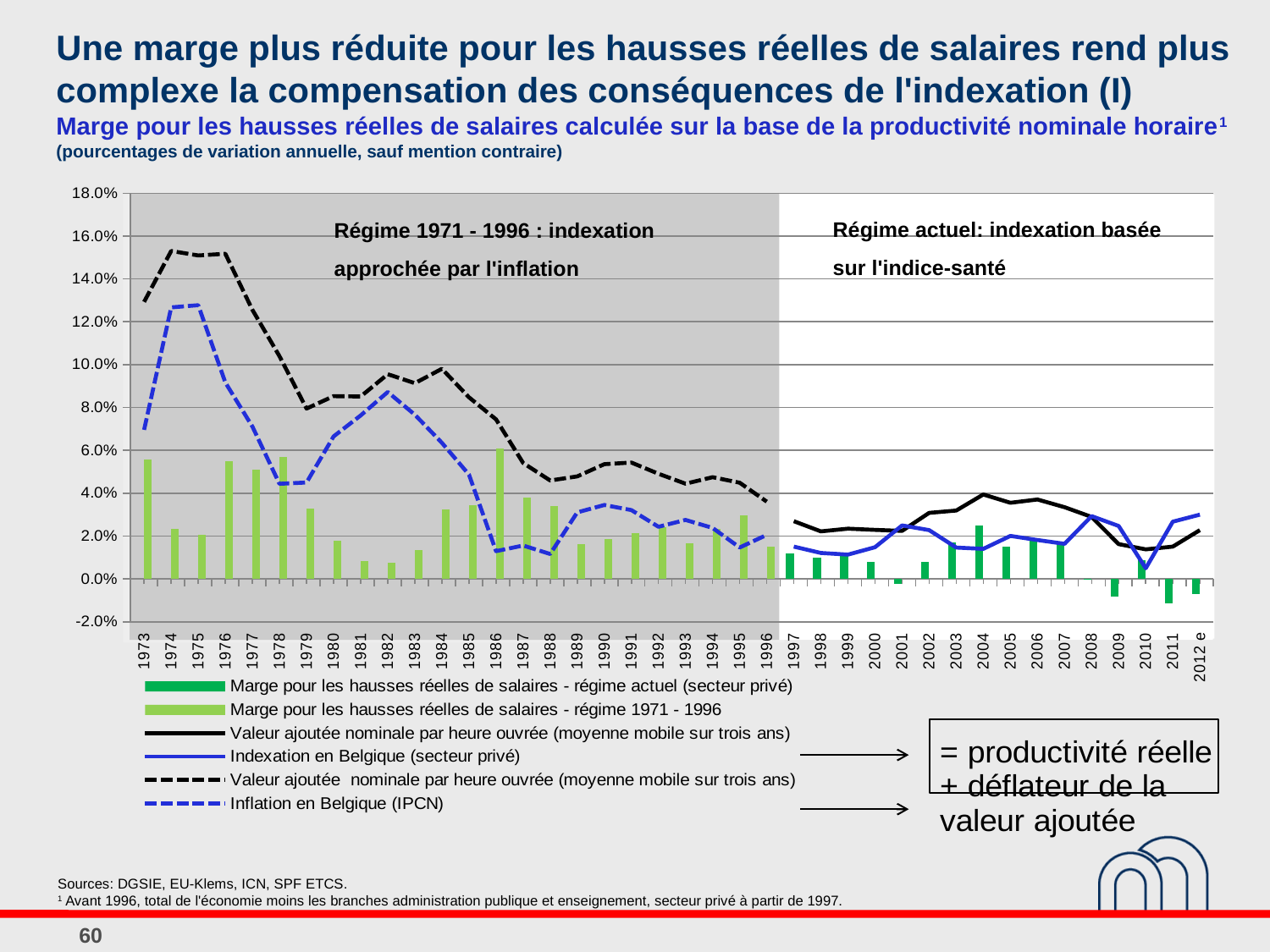
What label is given to the shaded period 1971 - 1996 in the chart? Régime 1971 - 1996 : indexation approchée par l'inflation Is the value of the solid blue line (indexation en Belgique) in 2010 greater or less than 2.0%? less Does the dashed black line (valeur ajoutée nominale par heure ouvrée) generally rise or fall between 1974 and 1996? Fall What kind of chart is shown on the slide? A combined bar and line chart What is the highest value shown on the y axis? 18.0% Is the value of the dashed blue line (inflation en Belgique, IPCN) in 1974 greater or less than 12.0%? greater How many years are shown along the x axis (from 1973 to 2012e)? 40 How many series does the legend list? 6 Is the value of the solid black line (valeur ajoutée nominale par heure ouvrée) in 2004 greater or less than 2.0%? greater In 1980, which is higher: the dashed black line (valeur ajoutée nominale) or the dashed blue line (inflation)? The dashed black line (valeur ajoutée nominale)